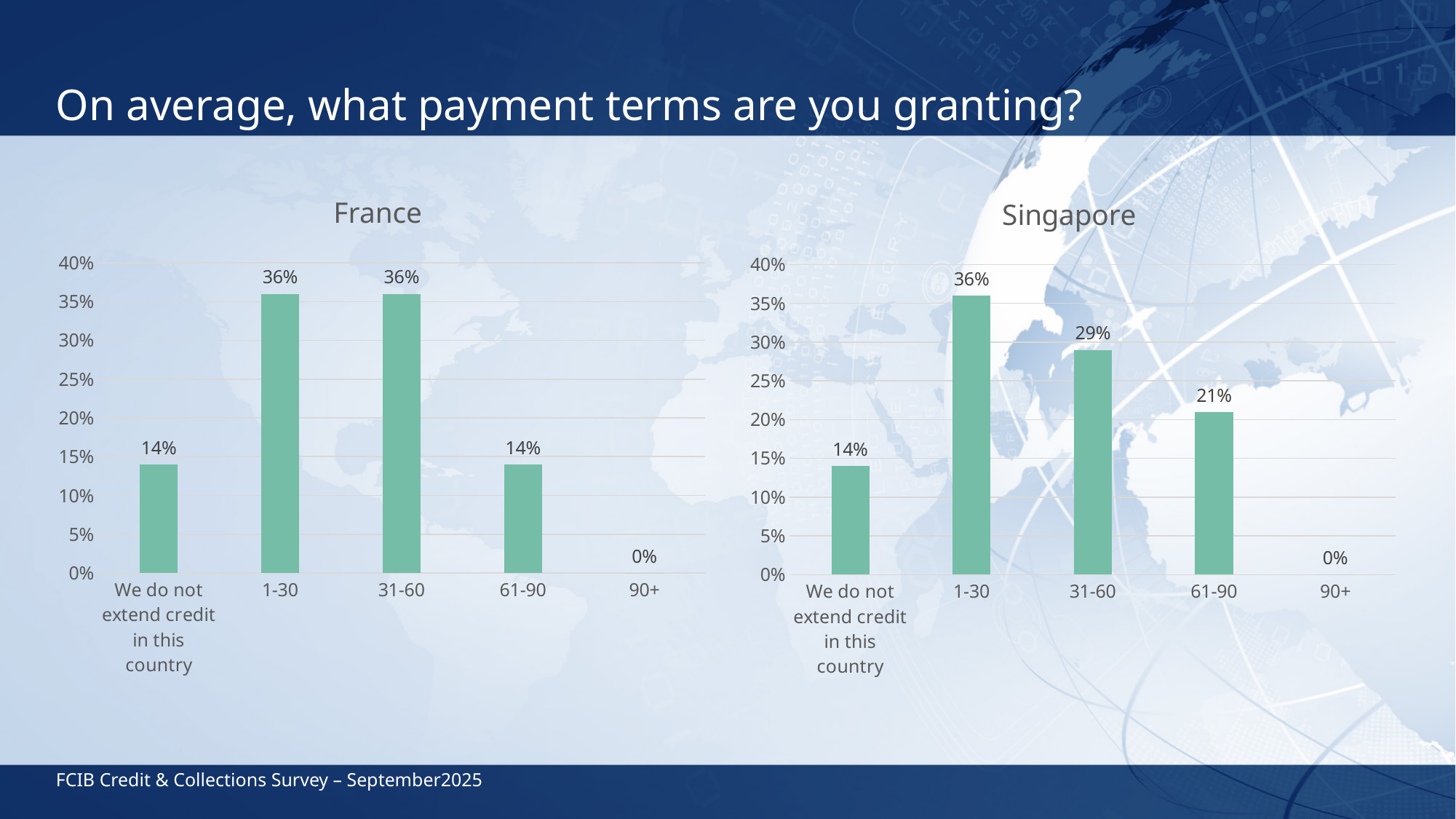
In the Singapore chart, what is the value for 31-60? 29% In the France chart, what is the value for 31-60? 36% What kind of chart is the Singapore chart? Bar chart In the France chart, what is the difference between the values for 1-30 and 61-90? 22% In the Singapore chart, what is the value for 61-90? 21% In the France chart, what is the value for 90+? 0% How many categories are shown on the x axis of the France chart? 5 In the France chart, which category has the lowest value? 90+ What is the title of the chart on the left side of the slide? France In the Singapore chart, which category has the highest value? 1-30 In the Singapore chart, what is the difference between the values for 1-30 and 31-60? 7% Which is larger: the value for 61-90 in the France chart or the value for 61-90 in the Singapore chart? Singapore